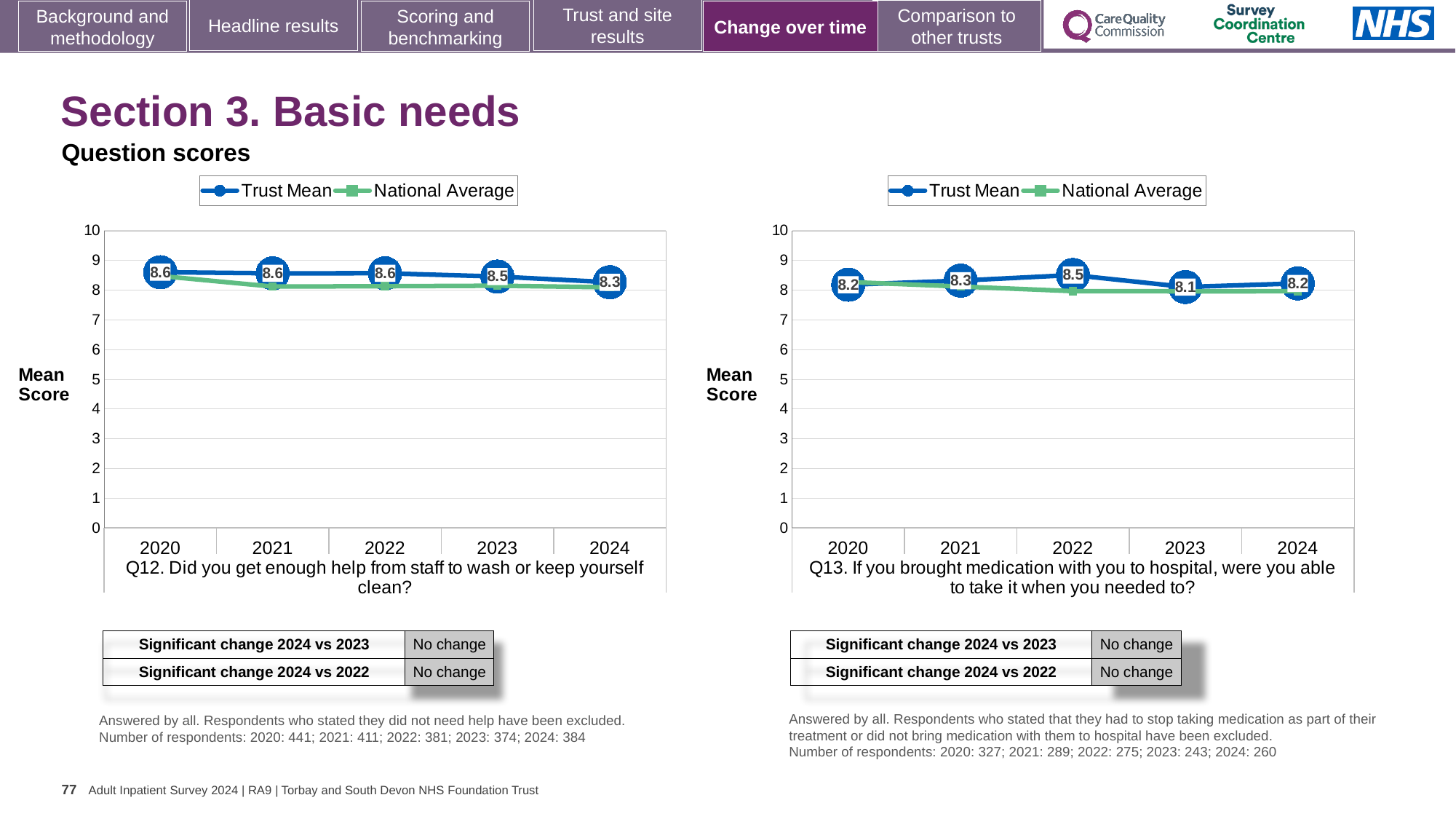
In the Q13 chart (right), is the Trust Mean higher in 2022 or in 2024? 2022 In the Q12 chart (left), what is the Trust Mean for 2024? 8.3 In the Q12 chart (left), what is the difference between the Trust Mean in 2020 and in 2024? 0.3 How many series does the legend of the Q13 chart (right) list? 2 In the Q12 chart (left), what is the Trust Mean for 2020? 8.6 In the Q13 chart (right), what is the difference between the Trust Mean in 2022 and in 2023? 0.4 How many years are plotted on the x axis of the Q12 chart (left)? 5 In the Q13 chart (right), what is the Trust Mean for 2022? 8.5 In the Q13 chart (right), which year has the lowest Trust Mean? 2023 In the Q13 chart (right), which year has the highest Trust Mean? 2022 In the Q12 chart (left), is the National Average for 2024 greater or less than 5? greater What type of chart is the Q12 chart (left)? Line chart